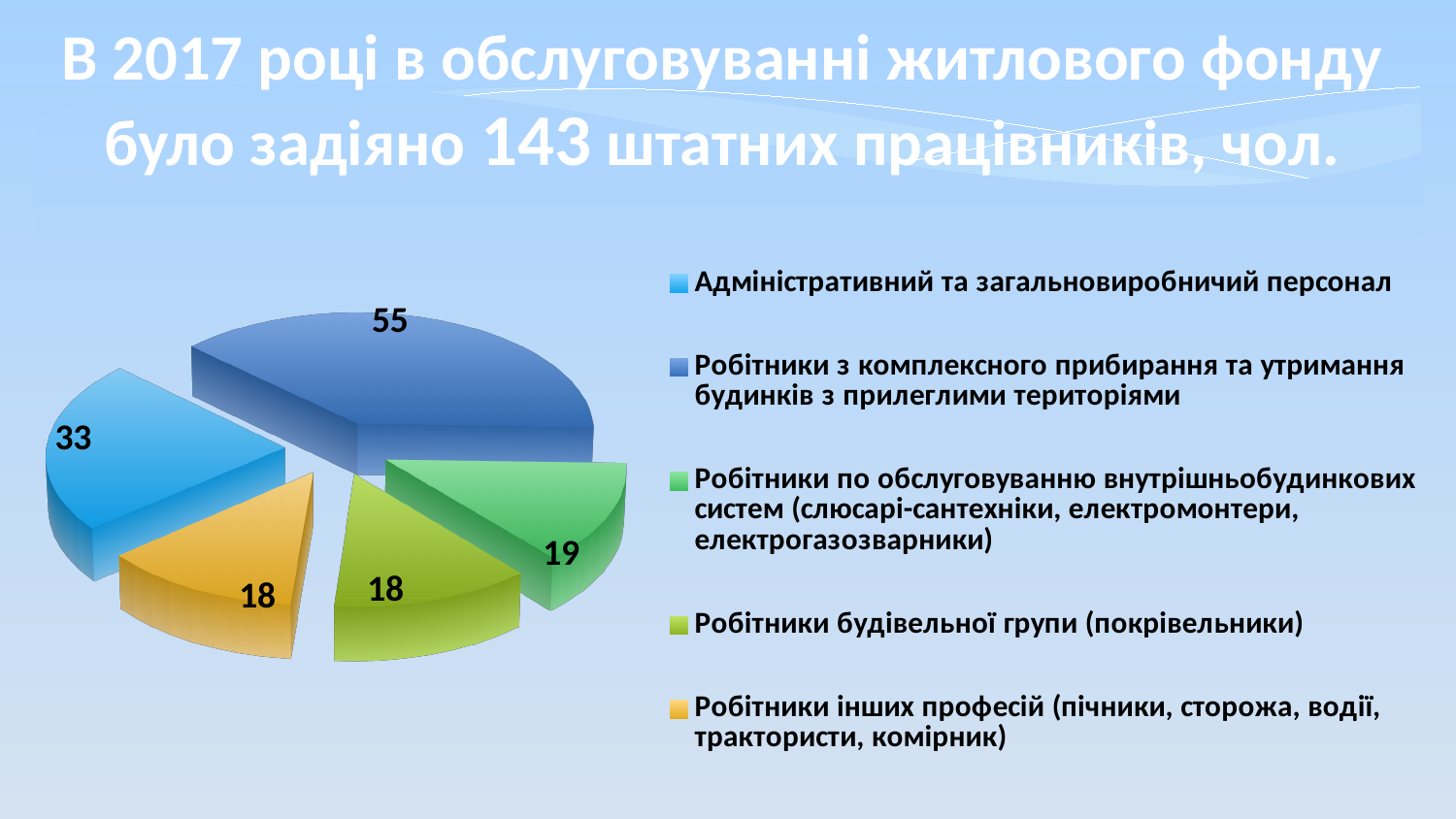
What is the value for Робітники будівельної групи (покрівельники)? 18 What is the total of all the slice values in the pie chart? 143 Which category has the largest slice of the pie? Робітники з комплексного прибирання та утримання будинків з прилеглими територіями What is the value for Адміністративний та загальновиробничий персонал? 33 Which is larger: the value for Адміністративний та загальновиробничий персонал or the value for Робітники по обслуговуванню внутрішньобудинкових систем? Адміністративний та загальновиробничий персонал What is the value for Робітники з комплексного прибирання та утримання будинків з прилеглими територіями? 55 How many slices does the pie chart have? 5 What is the difference between the value for Робітники з комплексного прибирання та утримання будинків and the value for Адміністративний та загальновиробничий персонал? 22 What type of chart is shown on the slide? pie chart What is the value for Робітники по обслуговуванню внутрішньобудинкових систем (слюсарі-сантехніки, електромонтери, електрогазозварники)? 19 Which two categories share the smallest value in the pie chart? Робітники будівельної групи (покрівельники) and Робітники інших професій (пічники, сторожа, водії, трактористи, комірник) How many entries does the legend list? 5